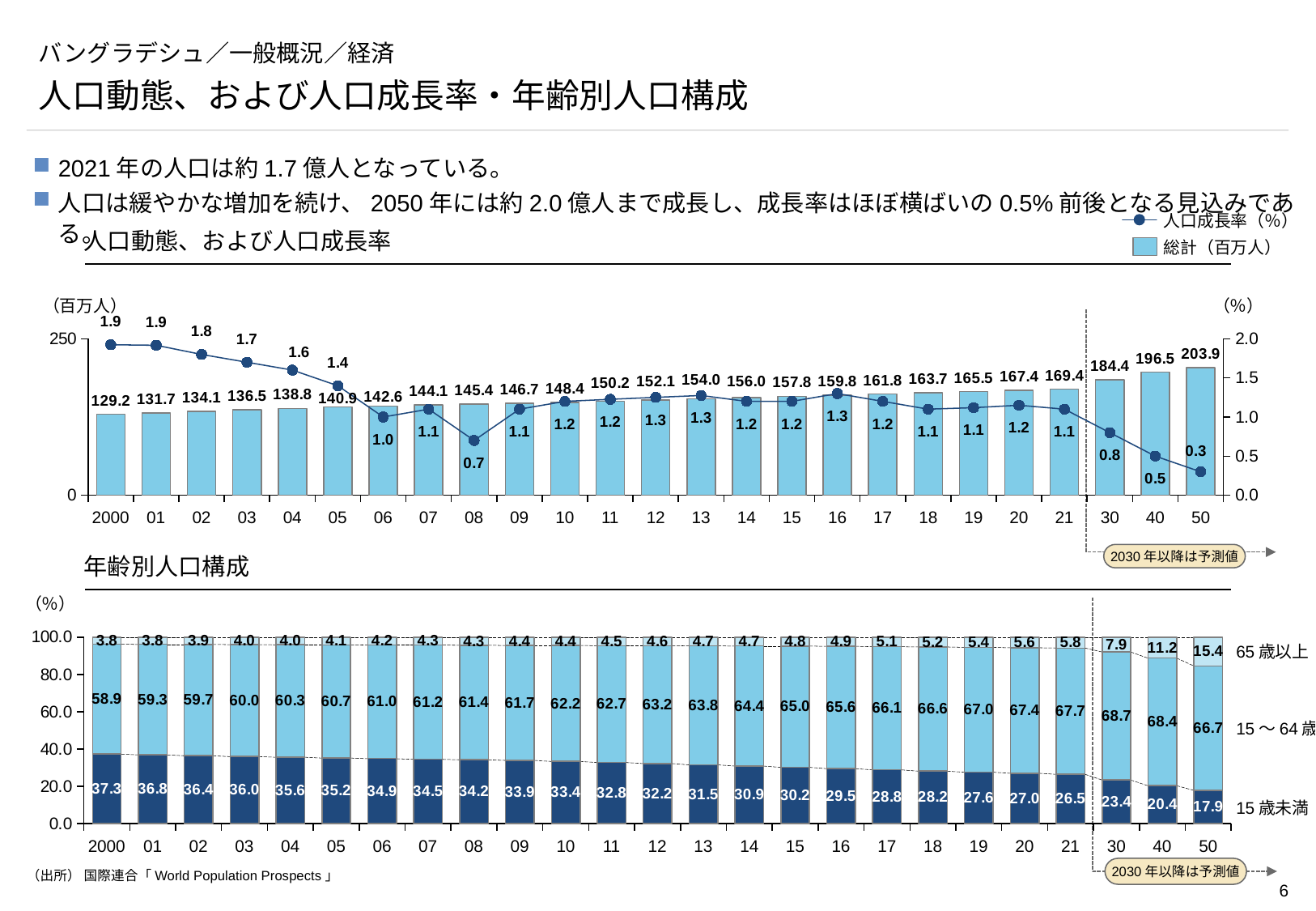
In the top chart (人口動態、および人口成長率), which year has the highest total population? 2050 What kind of chart is the bottom chart (年齢別人口構成)? Stacked bar chart In the top chart (人口動態、および人口成長率), how many years are shown on the x axis? 25 In the top chart (人口動態、および人口成長率), how many series does the legend list? 2 In the top chart (人口動態、および人口成長率), what is the population growth rate (人口成長率) shown for 2008? 0.7 In the bottom chart (年齢別人口構成), what is the share of 65歳以上 shown for 2050? 15.4 In the top chart (人口動態、および人口成長率), which year has the lowest population growth rate? 2050 In the top chart (人口動態、および人口成長率), what is the total population (総計, 百万人) shown for 2021? 169.4 In the top chart (人口動態、および人口成長率), which year has the higher population growth rate, 2006 or 2007? 2007 In the bottom chart (年齢別人口構成), does the share of 15歳未満 rise or fall from 2000 to 2050? Fall In the bottom chart (年齢別人口構成), what is the difference between the 15歳未満 share in 2000 and in 2021? 10.8 In the top chart (人口動態、および人口成長率), by how much does the total population for 2050 exceed that for 2021? 34.5